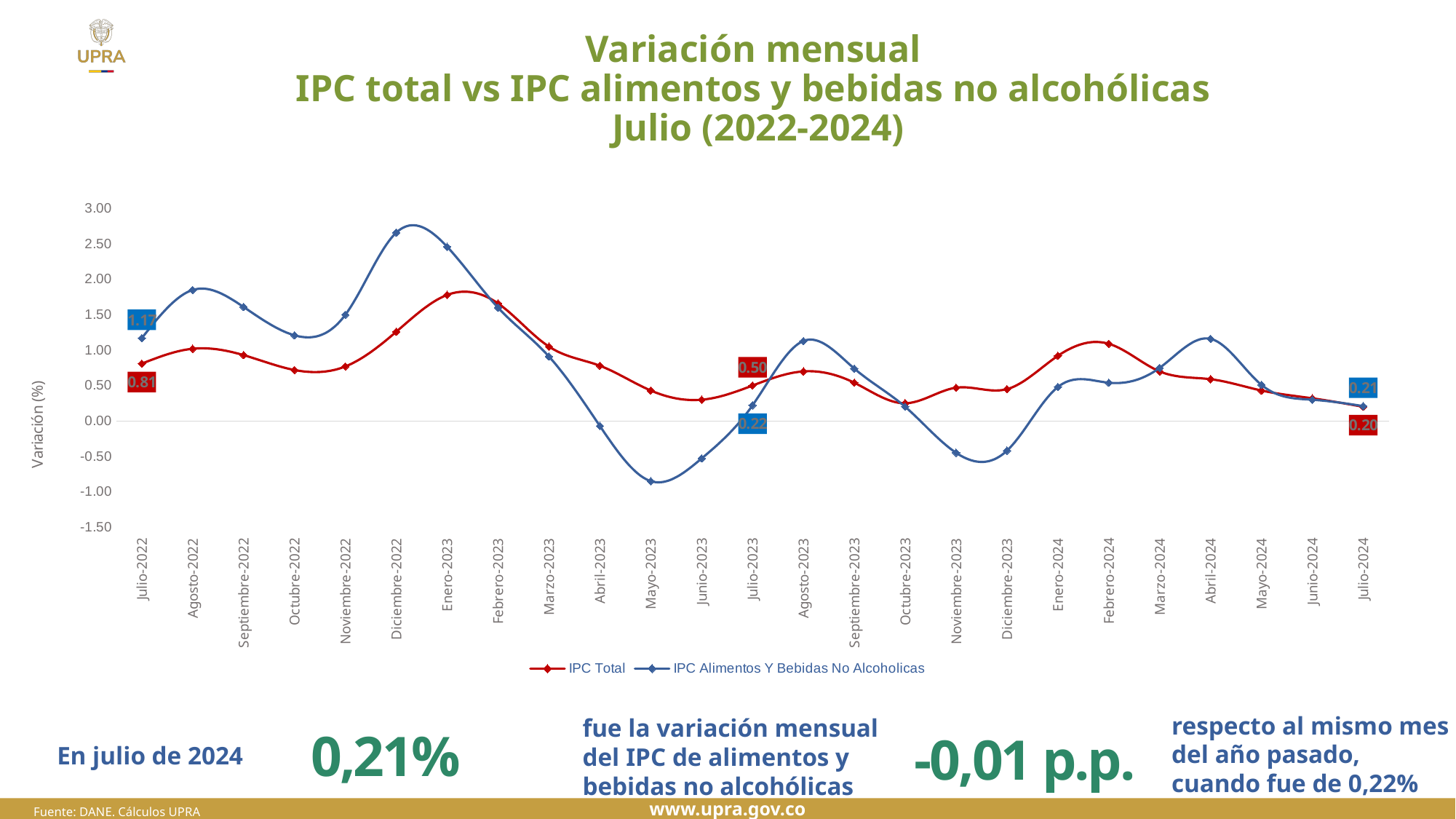
What is the value of IPC Total for Julio-2022? 0.81 Is the value of IPC Alimentos Y Bebidas No Alcoholicas for Diciembre-2022 greater or less than 2.50? greater In which month does the IPC Alimentos Y Bebidas No Alcoholicas series reach its lowest value? Mayo-2023 What is the value of IPC Alimentos Y Bebidas No Alcoholicas for Julio-2023? 0.22 In which month does the IPC Alimentos Y Bebidas No Alcoholicas series reach its highest value? Diciembre-2022 What is the value of IPC Alimentos Y Bebidas No Alcoholicas for Julio-2024? 0.21 In Julio-2023, which series has the larger value, IPC Total or IPC Alimentos Y Bebidas No Alcoholicas? IPC Total Does the IPC Alimentos Y Bebidas No Alcoholicas series rise or fall from Diciembre-2022 to Mayo-2023? fall What is the value of IPC Total for Julio-2023? 0.50 How many series does the legend list? 2 What is the difference between IPC Alimentos Y Bebidas No Alcoholicas and IPC Total in Julio-2022? 0.36 How many months are shown on the x axis? 25